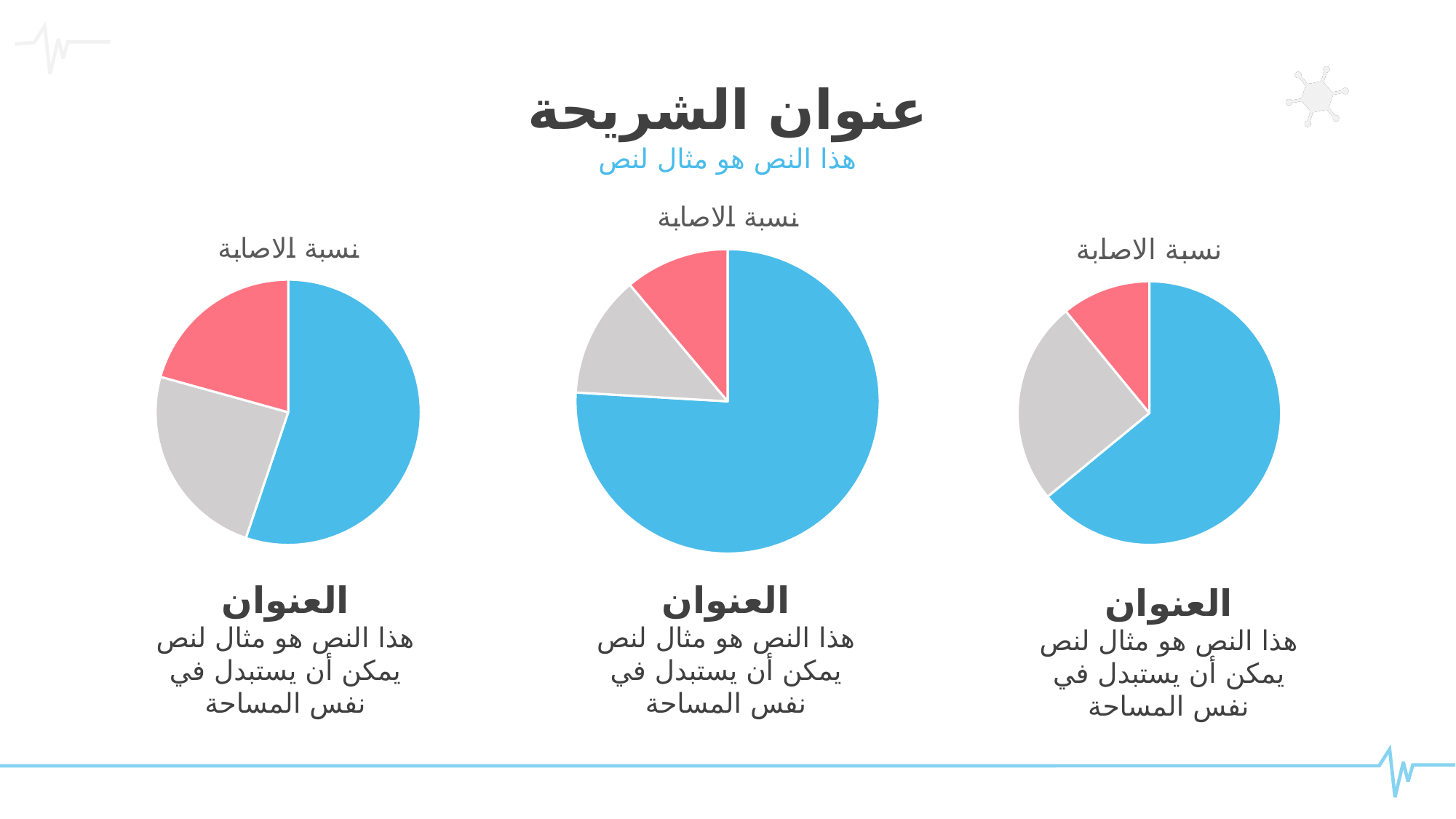
In the middle pie chart, is the blue slice greater or less than half of the pie? greater In the right pie chart, is the blue slice greater or less than half of the pie? greater How many pie charts are shown on the slide? 3 In the left pie chart, which colour slice is the largest? blue In the middle pie chart, which colour slice is the largest? blue How many slices does the middle pie chart have? 3 How many different colours are used for the slices in the left pie chart? 3 What kind of chart is the left chart on the slide? pie chart In the right pie chart, which is larger, the grey slice or the pink slice? grey What is the title shown above the middle pie chart? نسبة الاصابة In the right pie chart, which colour slice is the smallest? pink